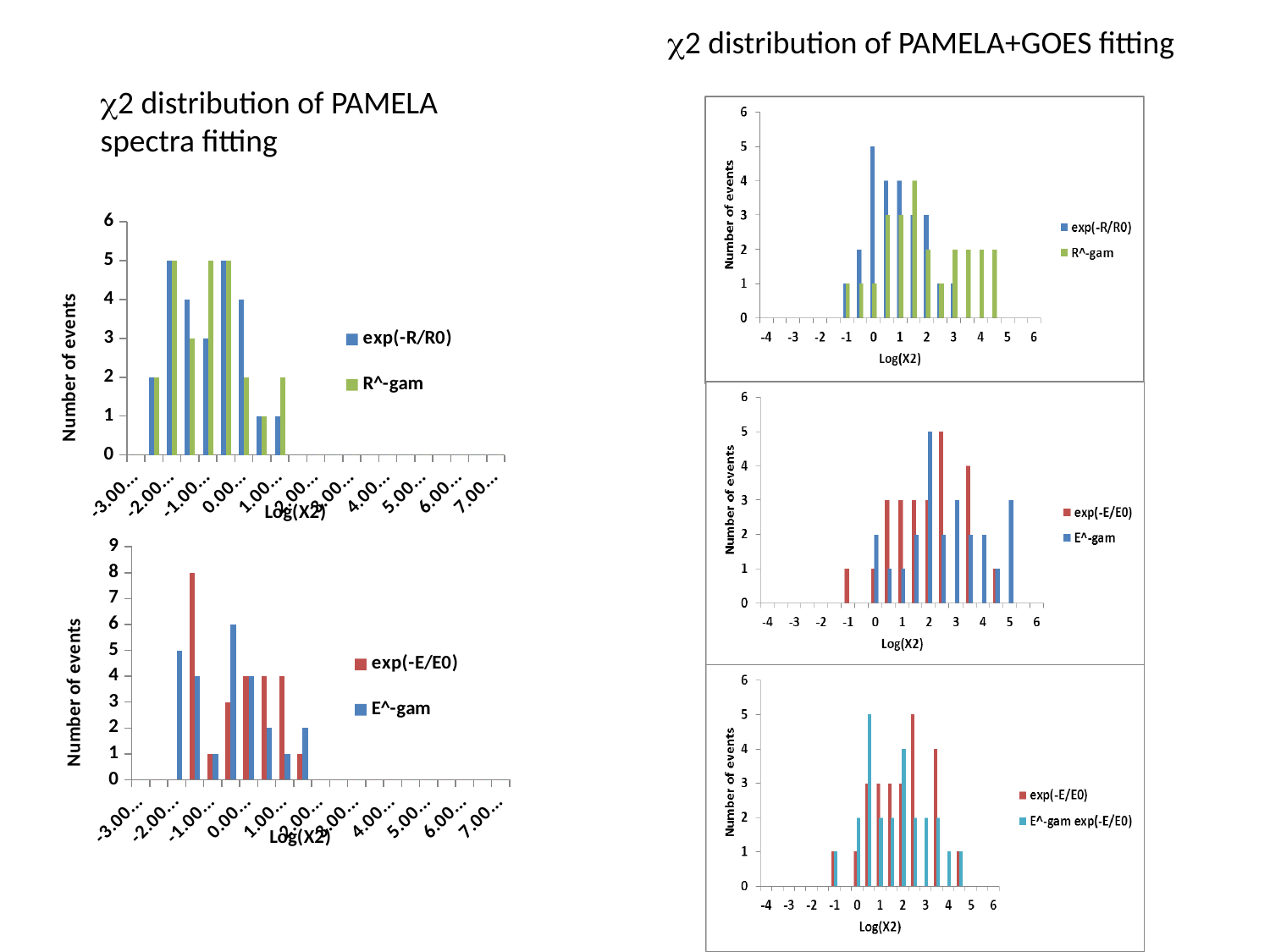
What kind of chart is the upper-left chart under 'χ2 distribution of PAMELA spectra fitting'? bar chart In the top-right chart of the PAMELA+GOES fitting, is the tallest exp(-R/R0) bar greater or less than 4? greater What are the two legend entries of the lower-left chart? exp(-E/E0) and E^-gam In the upper-left chart, what is the maximum number of events reached by any bar? 5 In the top-right chart of the PAMELA+GOES fitting, what is the highest value reached by the exp(-R/R0) series? 5 In the lower-left chart, what is the highest number of events reached by any bar? 8 What is the second legend entry of the bottom-right chart of the PAMELA+GOES fitting? E^-gam exp(-E/E0) How many series does the legend of the lower-left chart list? 2 How many charts are shown on the slide in total? 5 In the lower-left chart, which series has the tallest bar, exp(-E/E0) or E^-gam? exp(-E/E0)